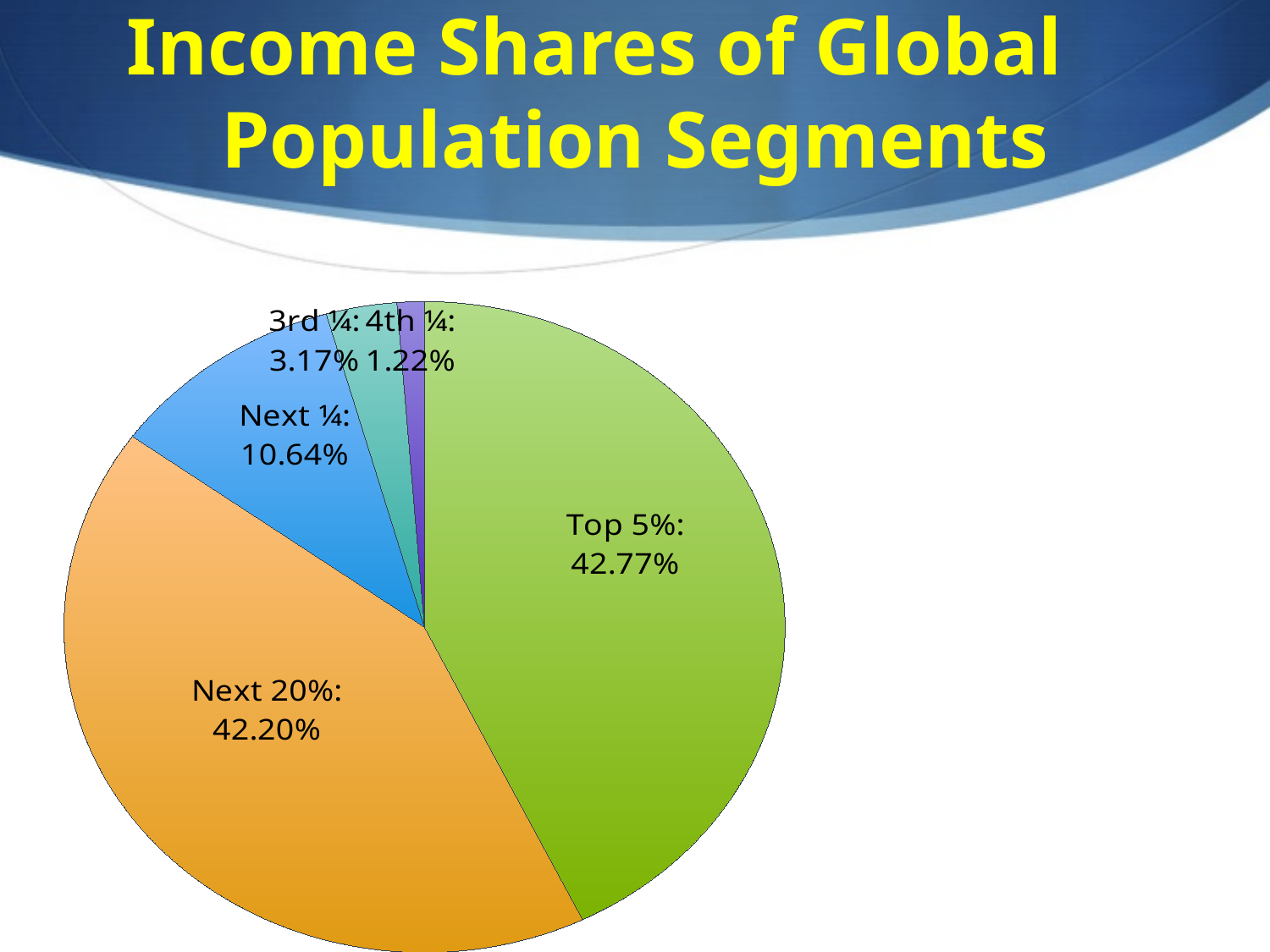
What is the income share of the 4th ¼ segment? 1.22% What is the difference between the income shares of the Next ¼ segment and the 3rd ¼ segment? 7.47% Which has the larger income share, the Next ¼ segment or the 3rd ¼ segment? Next ¼ What is the title of the slide? Income Shares of Global Population Segments What is the income share of the Next ¼ segment? 10.64% Which population segment has the smallest income share? 4th ¼ What is the income share of the Top 5% segment? 42.77% What kind of chart is shown on the slide? Pie chart What is the income share of the 3rd ¼ segment? 3.17% How many population segments are shown in the pie chart? 5 What is the difference between the income shares of the Next 20% segment and the Next ¼ segment? 31.56% What is the income share of the Next 20% segment? 42.20%